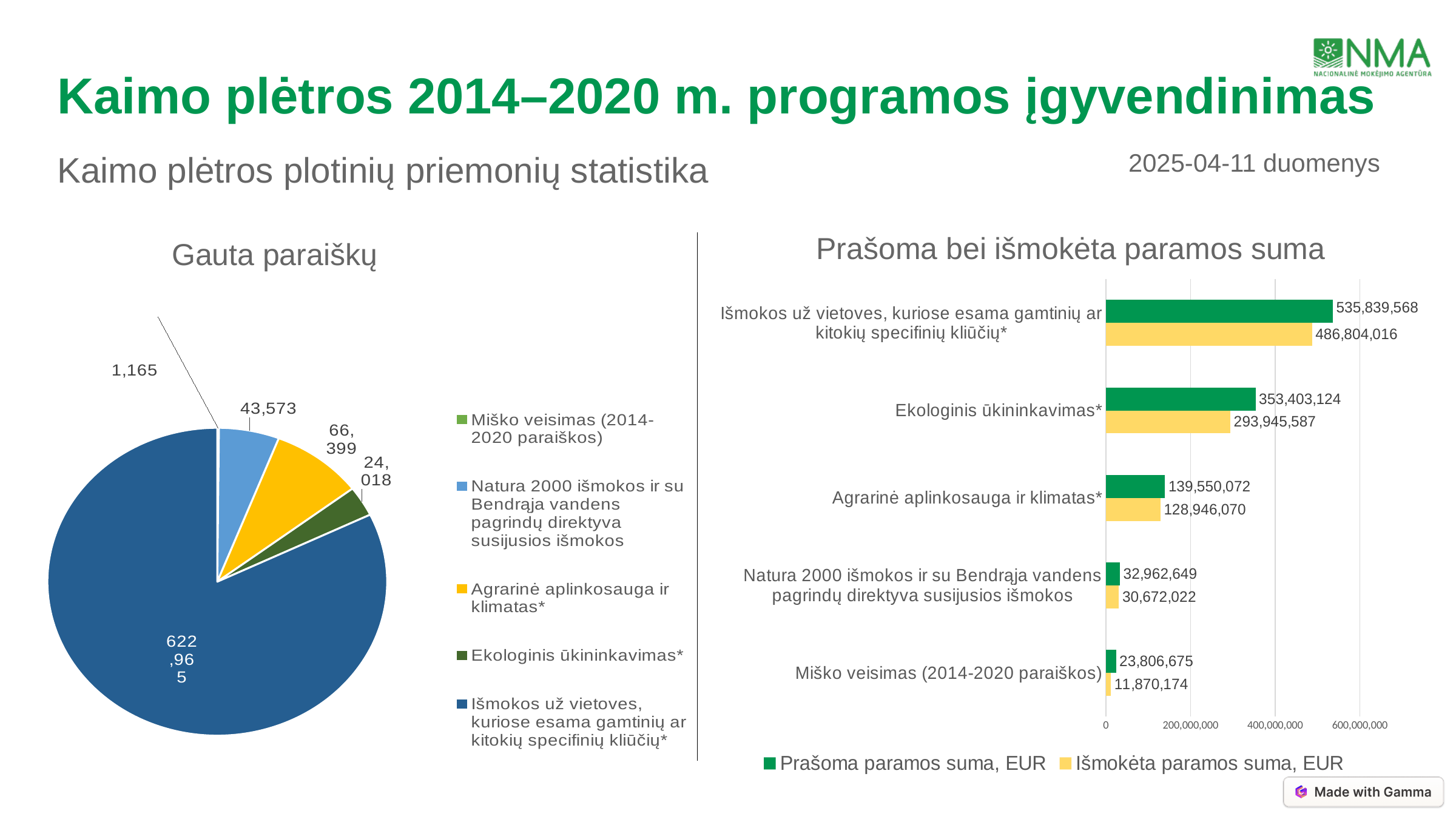
In the 'Gauta paraiškų' pie chart, which category has the smallest slice? Miško veisimas (2014-2020 paraiškos) In the 'Prašoma bei išmokėta paramos suma' chart, how many series does the legend list? 2 In the 'Prašoma bei išmokėta paramos suma' chart, what is the Išmokėta paramos suma, EUR for Miško veisimas (2014-2020 paraiškos)? 11,870,174 In the 'Prašoma bei išmokėta paramos suma' chart, which category has the highest Prašoma paramos suma, EUR? Išmokos už vietoves, kuriose esama gamtinių ar kitokių specifinių kliūčių* In the 'Gauta paraiškų' pie chart, how many applications were received for Išmokos už vietoves, kuriose esama gamtinių ar kitokių specifinių kliūčių*? 622,965 In the 'Prašoma bei išmokėta paramos suma' chart, what is the Prašoma paramos suma, EUR for Ekologinis ūkininkavimas*? 353,403,124 In the 'Prašoma bei išmokėta paramos suma' chart, what is the difference between the requested and paid amounts for Agrarinė aplinkosauga ir klimatas*? 10,604,002 In the 'Gauta paraiškų' pie chart, what is the value for Natura 2000 išmokos ir su Bendrąja vandens pagrindų direktyva susijusios išmokos? 43,573 In the 'Gauta paraiškų' pie chart, what is the difference between Agrarinė aplinkosauga ir klimatas* and Ekologinis ūkininkavimas*? 42,381 In the 'Gauta paraiškų' pie chart, how many categories are shown? 5 What type of chart is 'Prašoma bei išmokėta paramos suma'? Bar chart What type of chart is 'Gauta paraiškų'? Pie chart